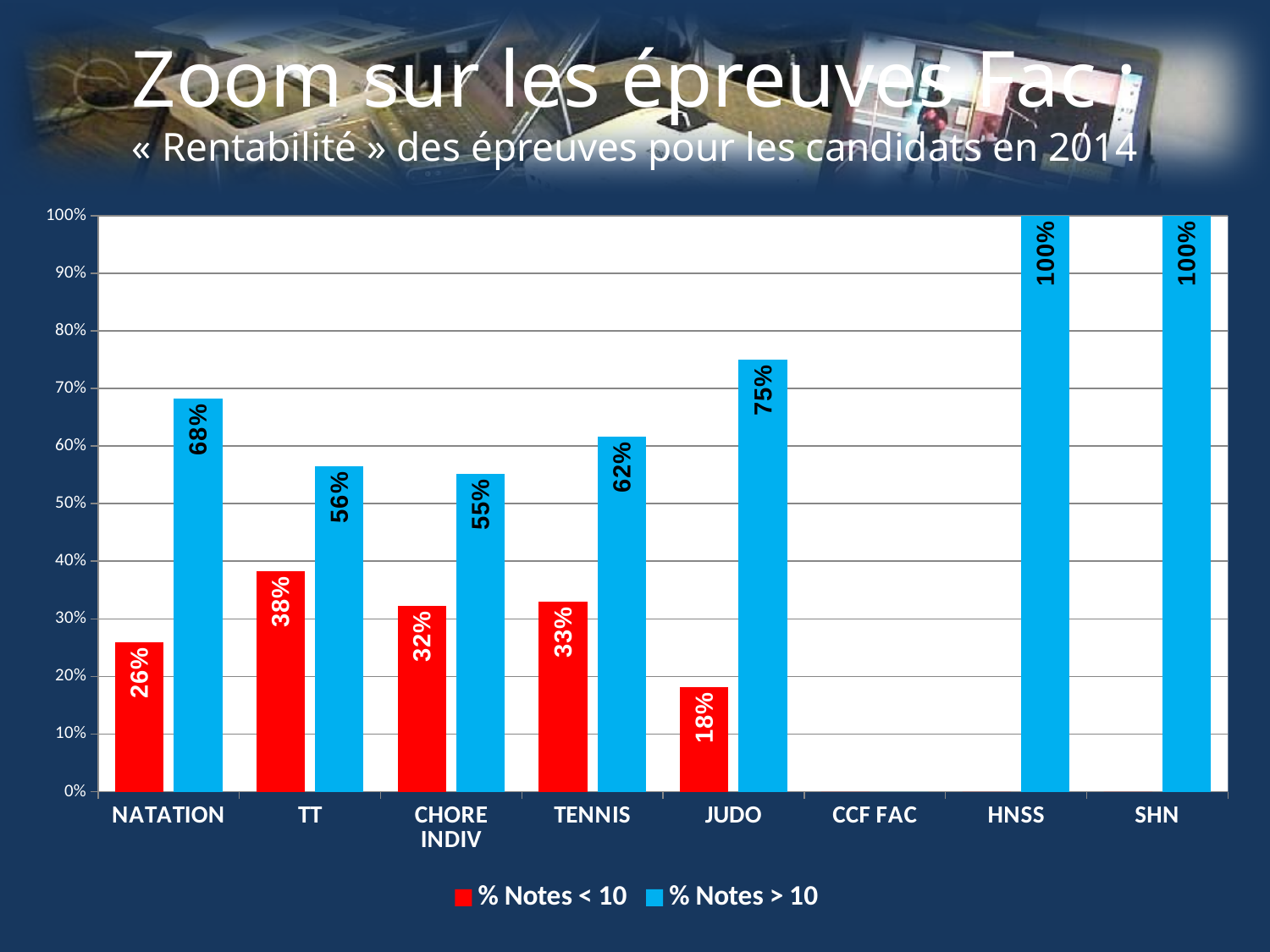
What is the value of "% Notes > 10" for TENNIS? 62% Which is larger: "% Notes > 10" for TT or for TENNIS? TENNIS What kind of chart is shown on the slide? Bar chart How many series does the legend list? 2 Is the value of "% Notes > 10" for JUDO greater or less than 70%? greater How many categories are shown on the x axis? 8 Which category has the highest value for "% Notes < 10"? TT Among the categories with a red bar, which has the lowest value for "% Notes < 10"? JUDO What is the value of "% Notes < 10" for JUDO? 18% What is the value of "% Notes > 10" for NATATION? 68% What is the difference between the "% Notes > 10" values for JUDO and CHORE INDIV? 20% What is the value of "% Notes < 10" for TT? 38%